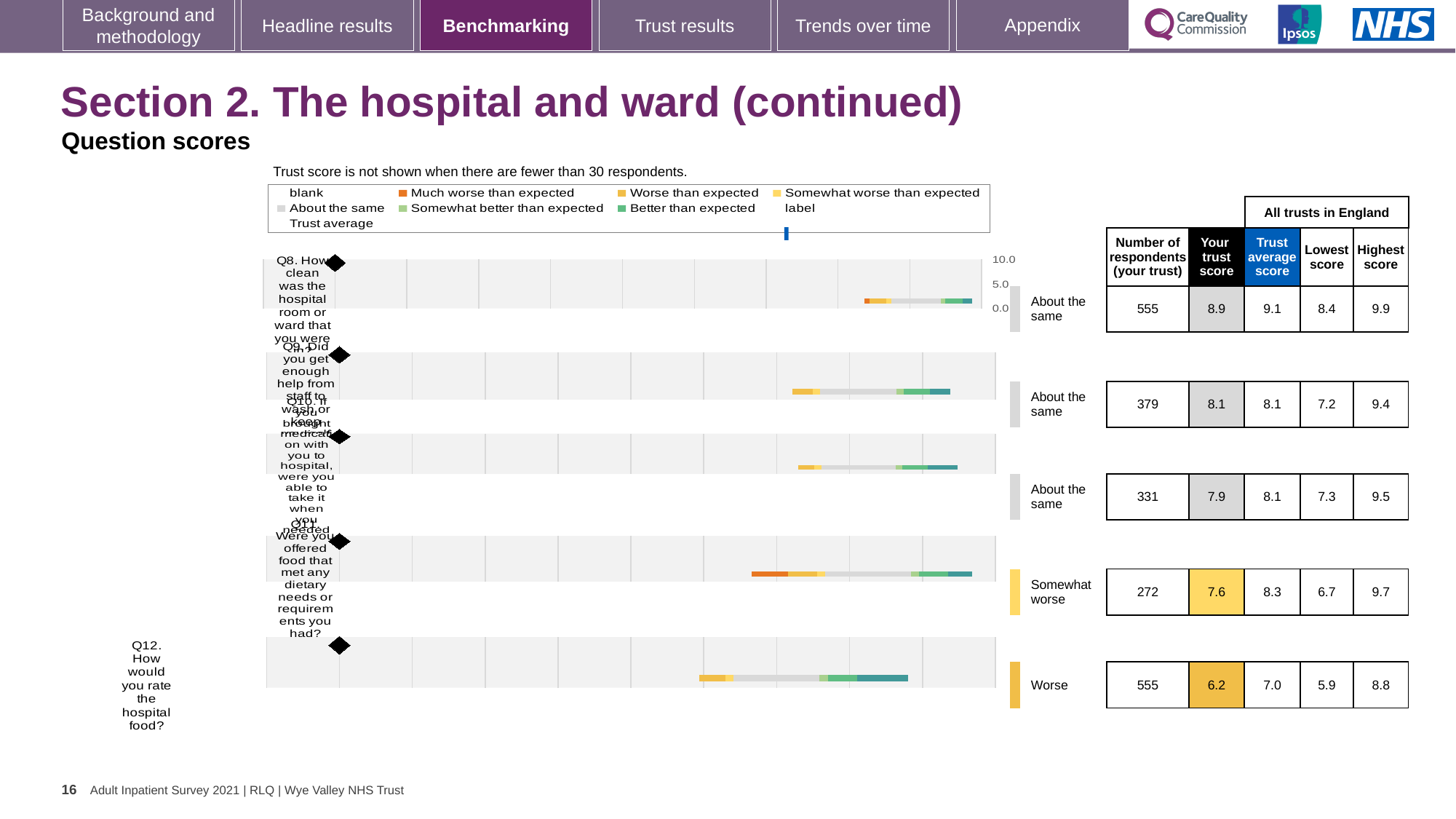
What is the lowest score across all trusts in England for Q10? 7.3 How many questions are plotted on this slide? 5 What is the difference between the trust average score and your trust score for Q11? 0.7 What is the 'Your trust score' for Q8 (How clean was the hospital room or ward)? 8.9 What is the highest score across all trusts in England for Q9? 9.4 What benchmark category is shown for Q12 (rating of hospital food)? Worse Which question has the highest 'Your trust score' on this slide? Q8 What kind of chart is used to show the question scores? Bar chart Which question has the lowest 'Your trust score' on this slide? Q12 For Q10, which is larger: your trust score or the trust average score? Trust average score How many respondents from your trust answered Q12 (How would you rate the hospital food)? 555 What benchmark category is shown for Q11 (food that met dietary needs)? Somewhat worse